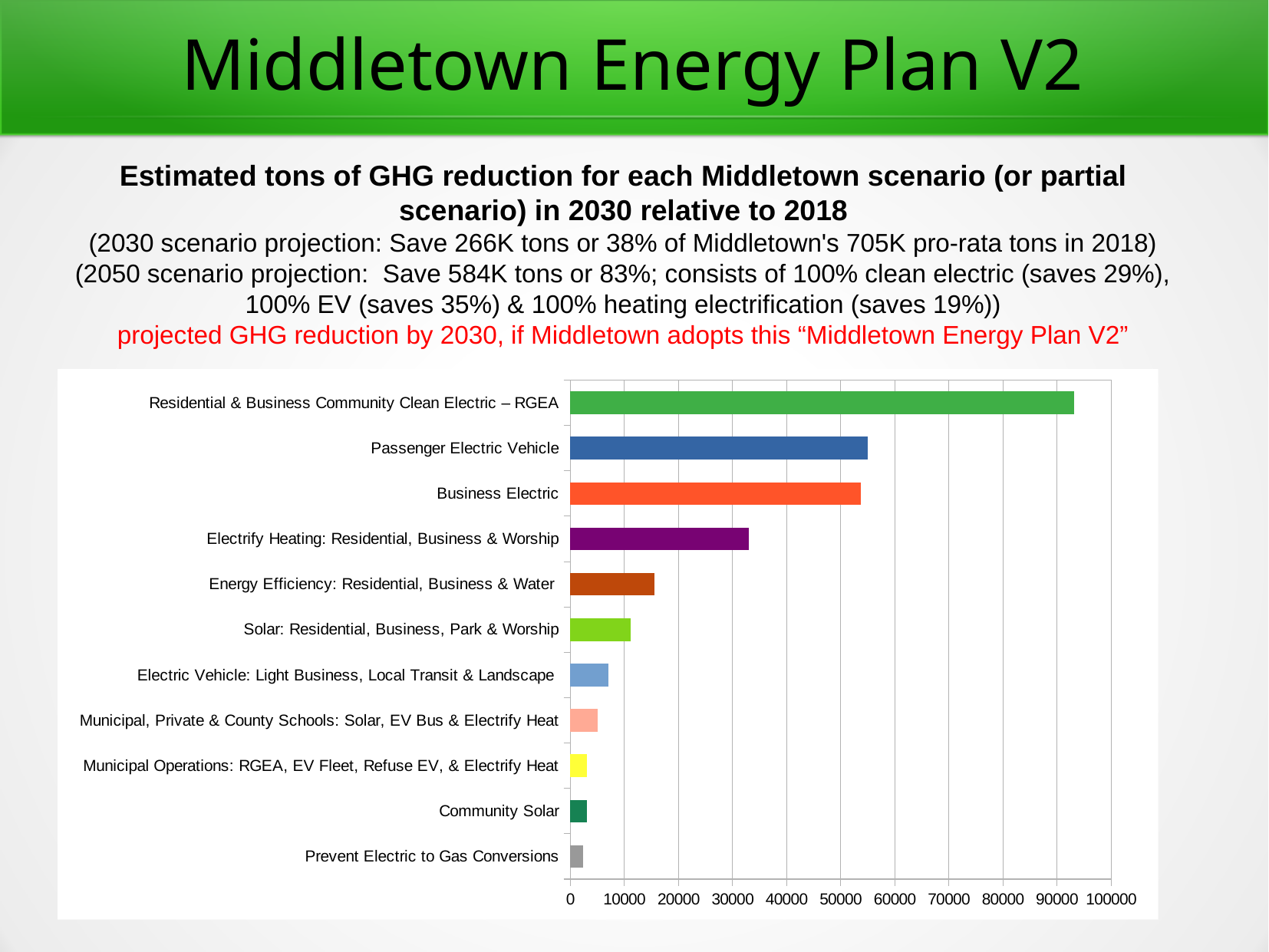
Is the value for Passenger Electric Vehicle greater or less than 50000? greater Is the value for Electric Vehicle: Light Business, Local Transit & Landscape greater or less than 10000? less How many categories (bars) does the chart show? 11 Is the value for Energy Efficiency: Residential, Business & Water greater or less than 20000? less What kind of chart is shown on the slide? bar chart Which category has the lowest estimated GHG reduction? Prevent Electric to Gas Conversions What is the highest value shown on the horizontal axis of the chart? 100000 Which category has the highest estimated GHG reduction? Residential & Business Community Clean Electric – RGEA Which is larger, the value for Electrify Heating: Residential, Business & Worship or the value for Energy Efficiency: Residential, Business & Water? Electrify Heating: Residential, Business & Worship Which is larger, the value for Solar: Residential, Business, Park & Worship or the value for Community Solar? Solar: Residential, Business, Park & Worship